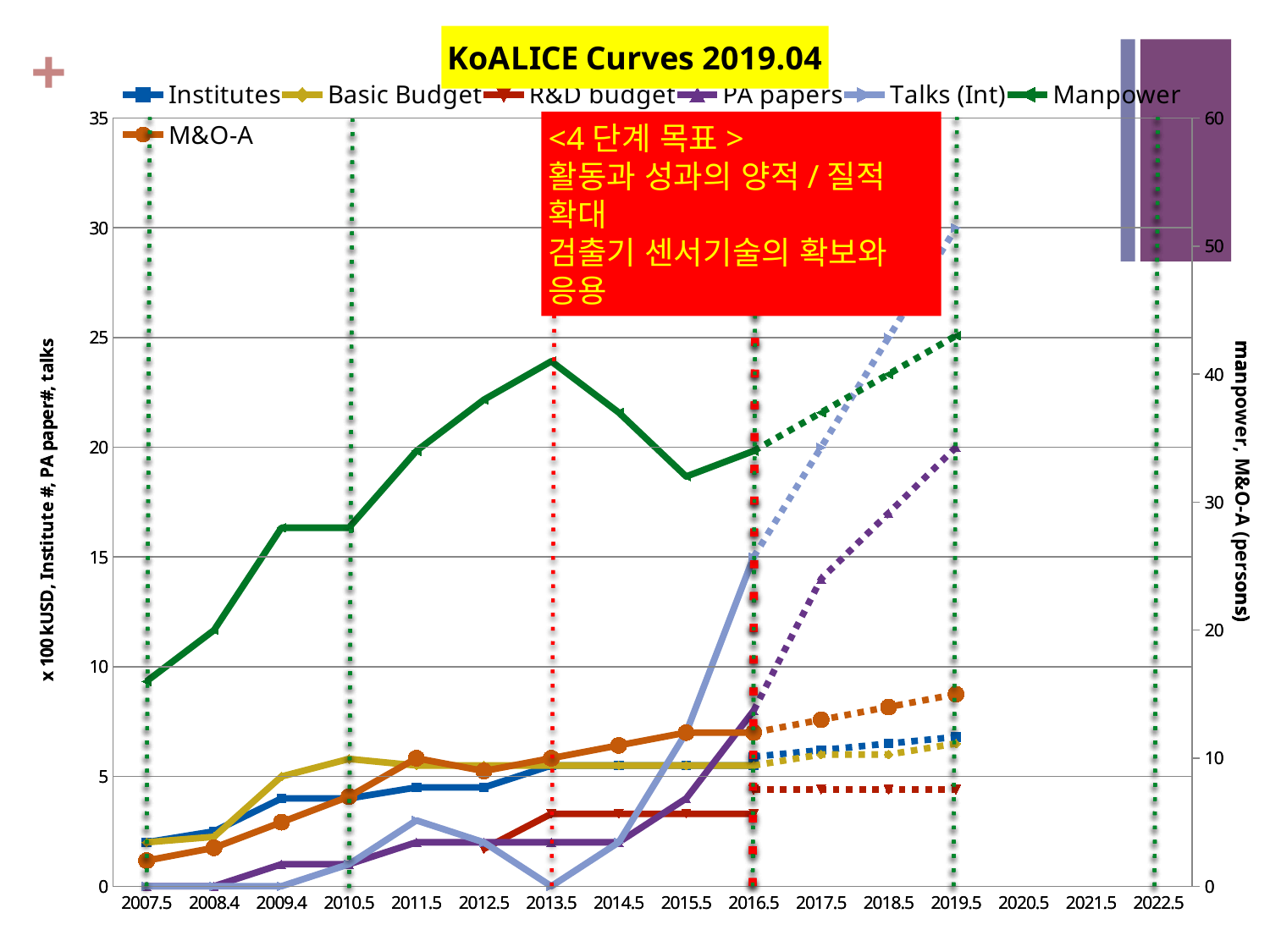
What colour is the Manpower line in the chart? green What kind of chart is shown on the slide? line chart Is the value for Institutes at 2016.5 greater or less than 10 on the left axis? less What is the value for Talks (Int) at 2013.5? 0 How many year labels are shown along the x axis of the chart? 16 Does the Manpower line rise or fall from 2007.5 to 2013.5? rise Is the Manpower value at 2007.5 greater or less than 20 persons on the right axis? less How many series does the chart's legend list? 7 Is the value for Talks (Int) at 2016.5 greater or less than 10 on the left axis? greater What is the title of the chart? KoALICE Curves 2019.04 What is the value for PA papers at 2007.5? 0